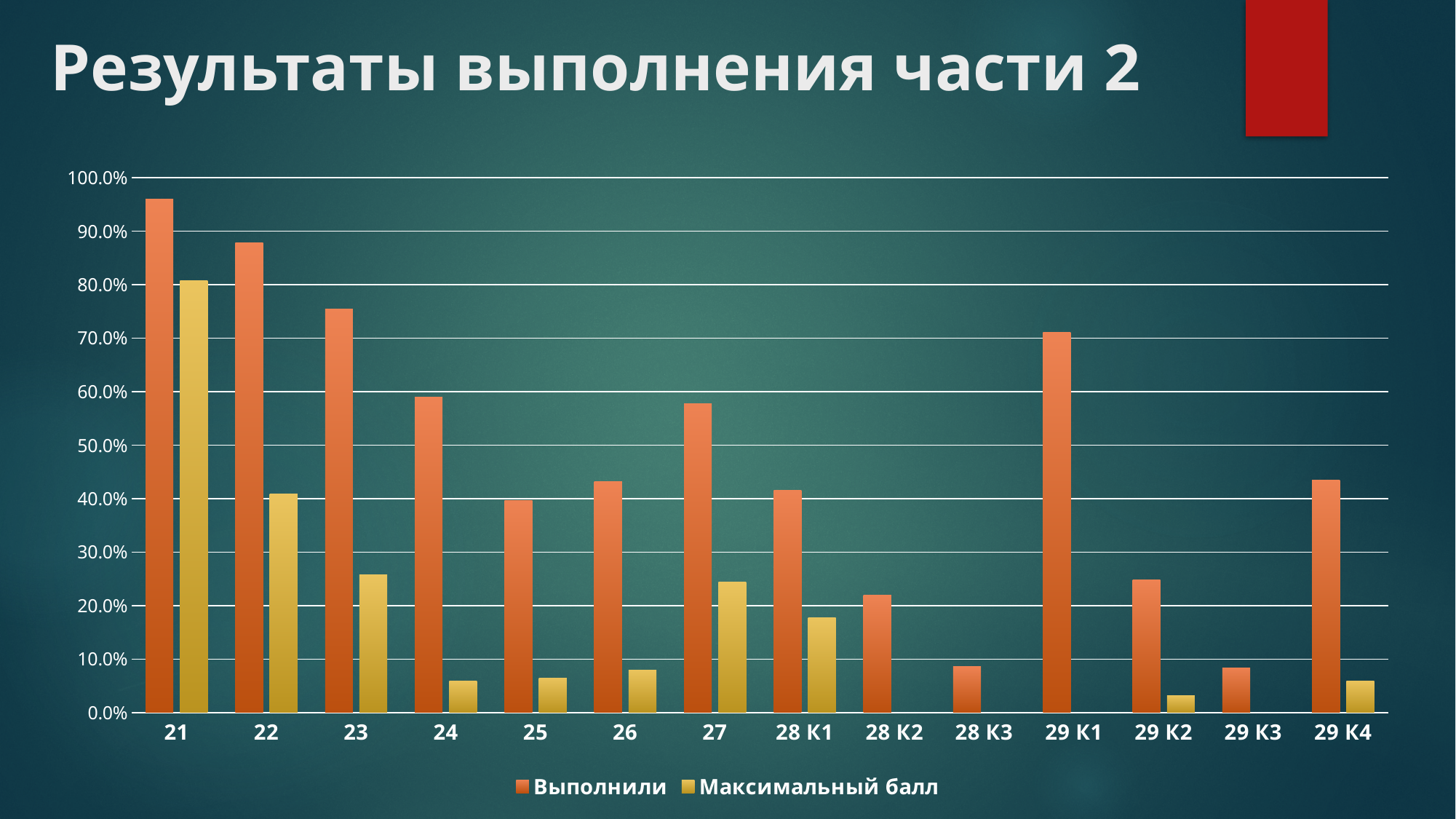
Which is larger, the Выполнили value for 22 or for 23? 22 What is the title of the slide? Результаты выполнения части 2 Is the Выполнили value for 29 К1 greater or less than 60.0%? greater Which category has the highest value for Выполнили? 21 Is the Максимальный балл value for 21 greater or less than 70.0%? greater Is the Выполнили value for 21 greater or less than 90.0%? greater Which category has the highest value for Максимальный балл? 21 What kind of chart is shown on the slide? bar chart How many series does the legend list? 2 How many categories are shown on the x axis? 14 Which is larger, the Максимальный балл value for 28 К1 or for 29 К2? 28 К1